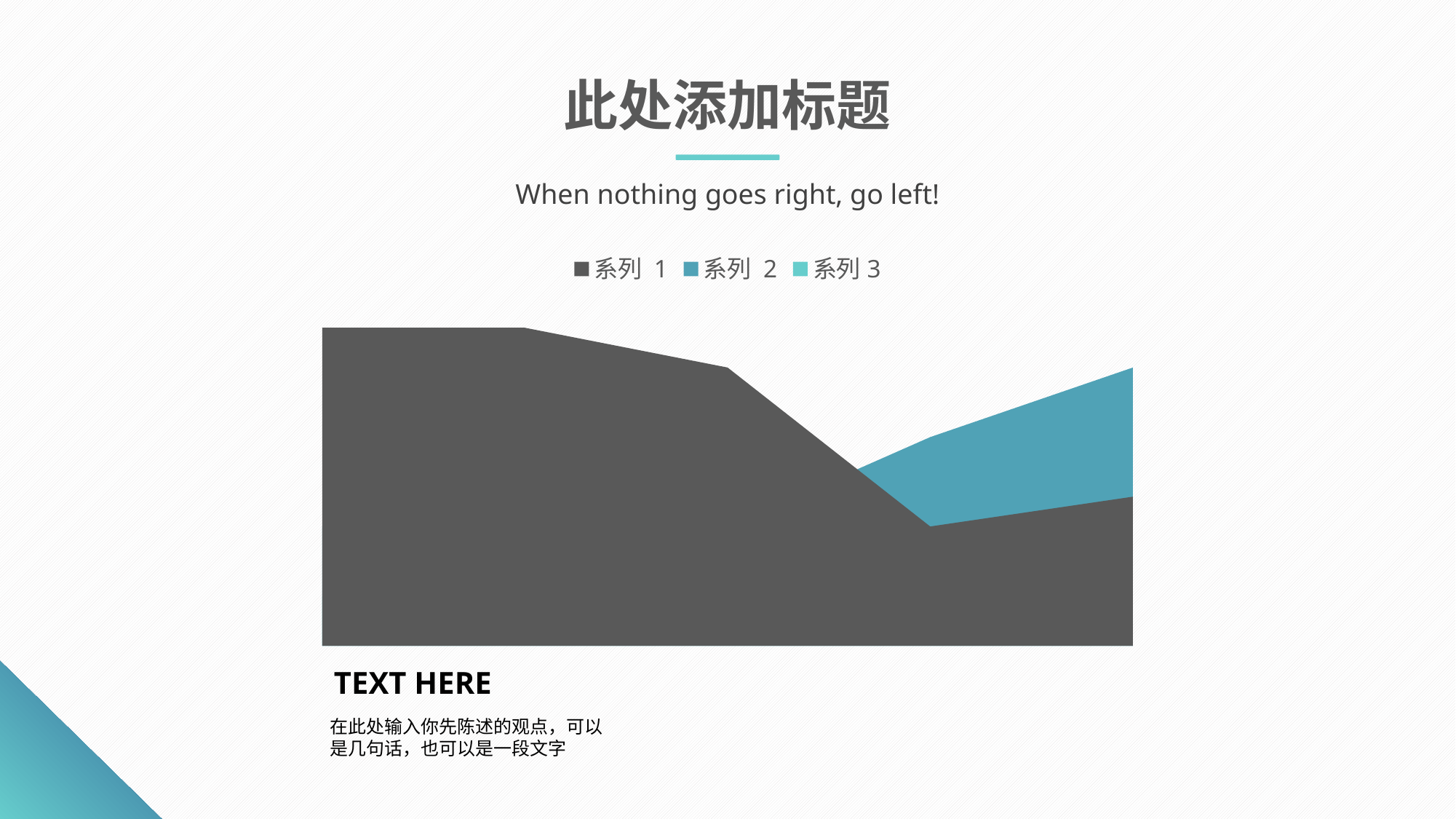
How many series does the legend list? 3 Does the value of 系列 1 overall rise or fall from the left end of the chart to the right end? Fall What are the series names listed in the legend? 系列 1, 系列 2, 系列 3 Which colour represents 系列 1 in the chart? Dark gray What kind of chart is shown on the slide? Area chart